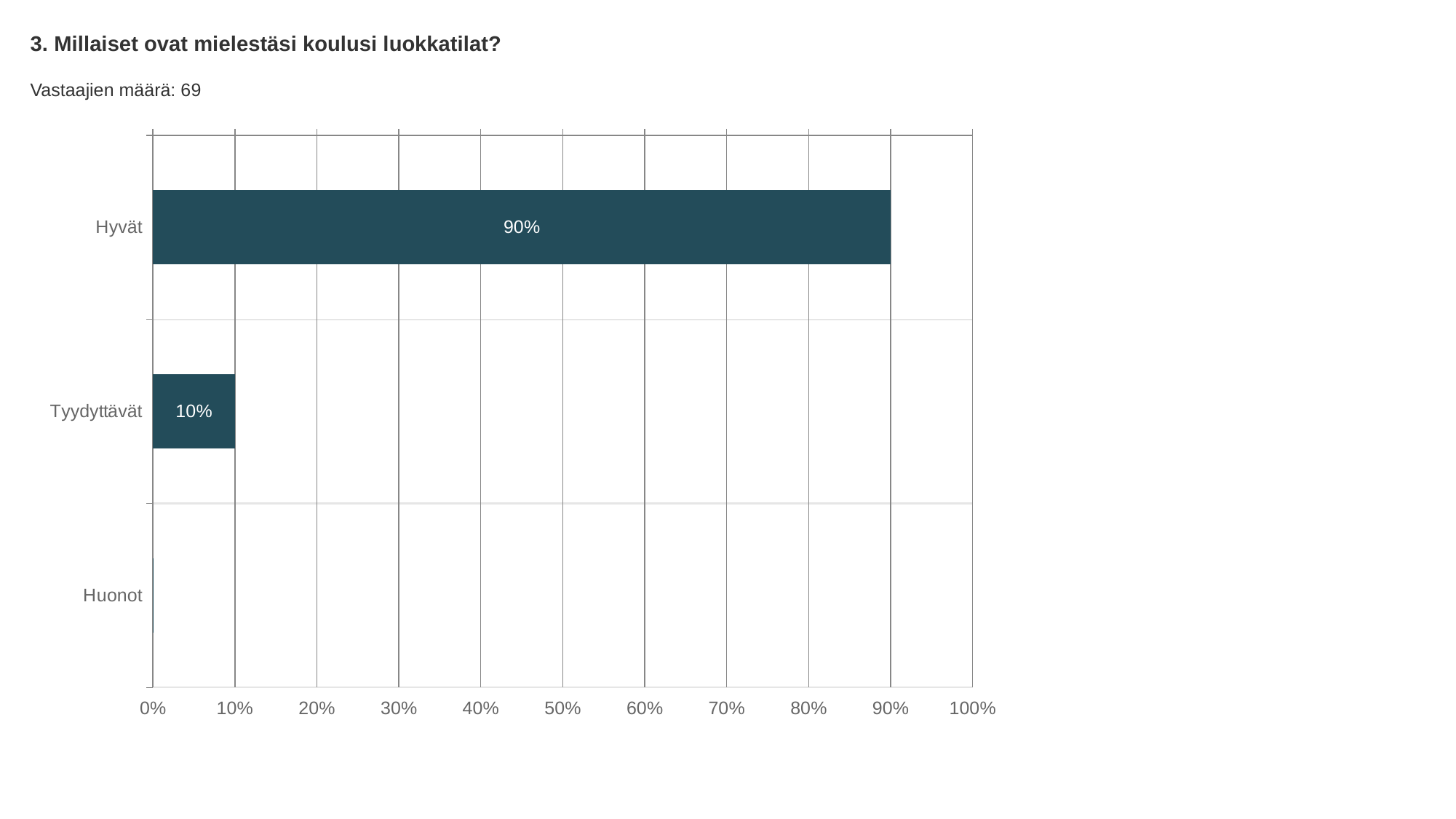
Which category has the lowest value? Huonot What is the value for Hyvät? 90% What is the difference between the values for Hyvät and Tyydyttävät? 80% Is the value for Hyvät greater or less than 50%? greater What is the title of the chart? 3. Millaiset ovat mielestäsi koulusi luokkatilat? What kind of chart is shown on the slide? bar chart How many categories are shown in the chart? 3 How many respondents (Vastaajien määrä) does the slide report? 69 Which is larger, the value for Hyvät or the value for Tyydyttävät? Hyvät What is the value for Tyydyttävät? 10% Is the value for Huonot greater or less than 10%? less Which category has the highest value? Hyvät